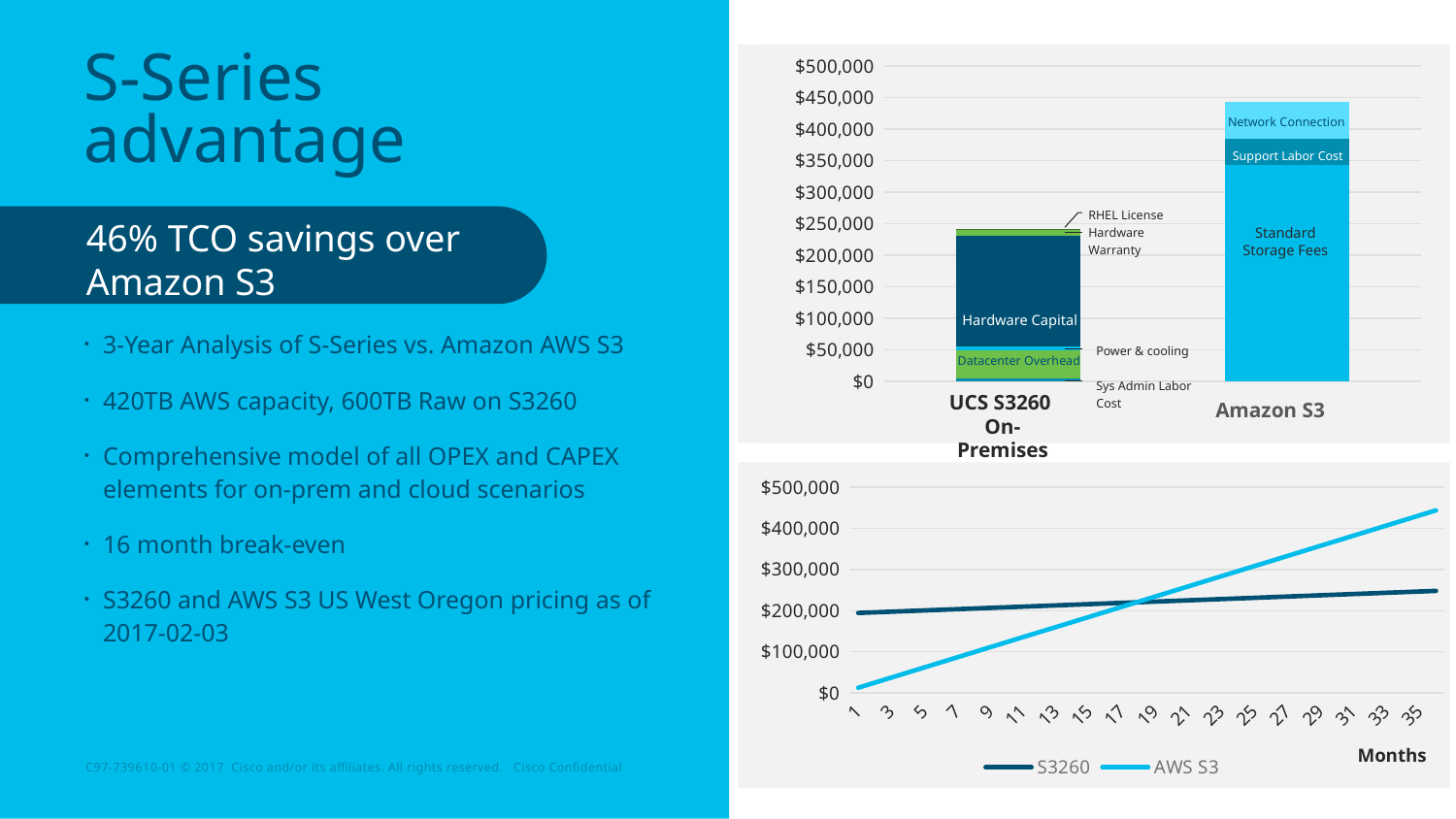
In the bottom chart, does the AWS S3 line rise or fall as the months increase? rise In the bottom chart, how many series does the legend list? 2 In the top chart, which category has the taller stacked bar? Amazon S3 In the top chart, how many categories are shown on the x axis? 2 What kind of chart is the bottom chart on the slide? line chart In the bottom chart, which series is higher at month 35, S3260 or AWS S3? AWS S3 In the top chart, is the total for Amazon S3 greater or less than $400,000? greater What kind of chart is the top chart on the slide? bar chart In the bottom chart, is the value for AWS S3 at month 35 greater or less than $400,000? greater In the bottom chart, what is the title of the x axis? Months In the top chart, which segment is labeled at the bottom of the UCS S3260 On-Premises bar? Datacenter Overhead In the top chart, is the total for UCS S3260 On-Premises greater or less than $300,000? less